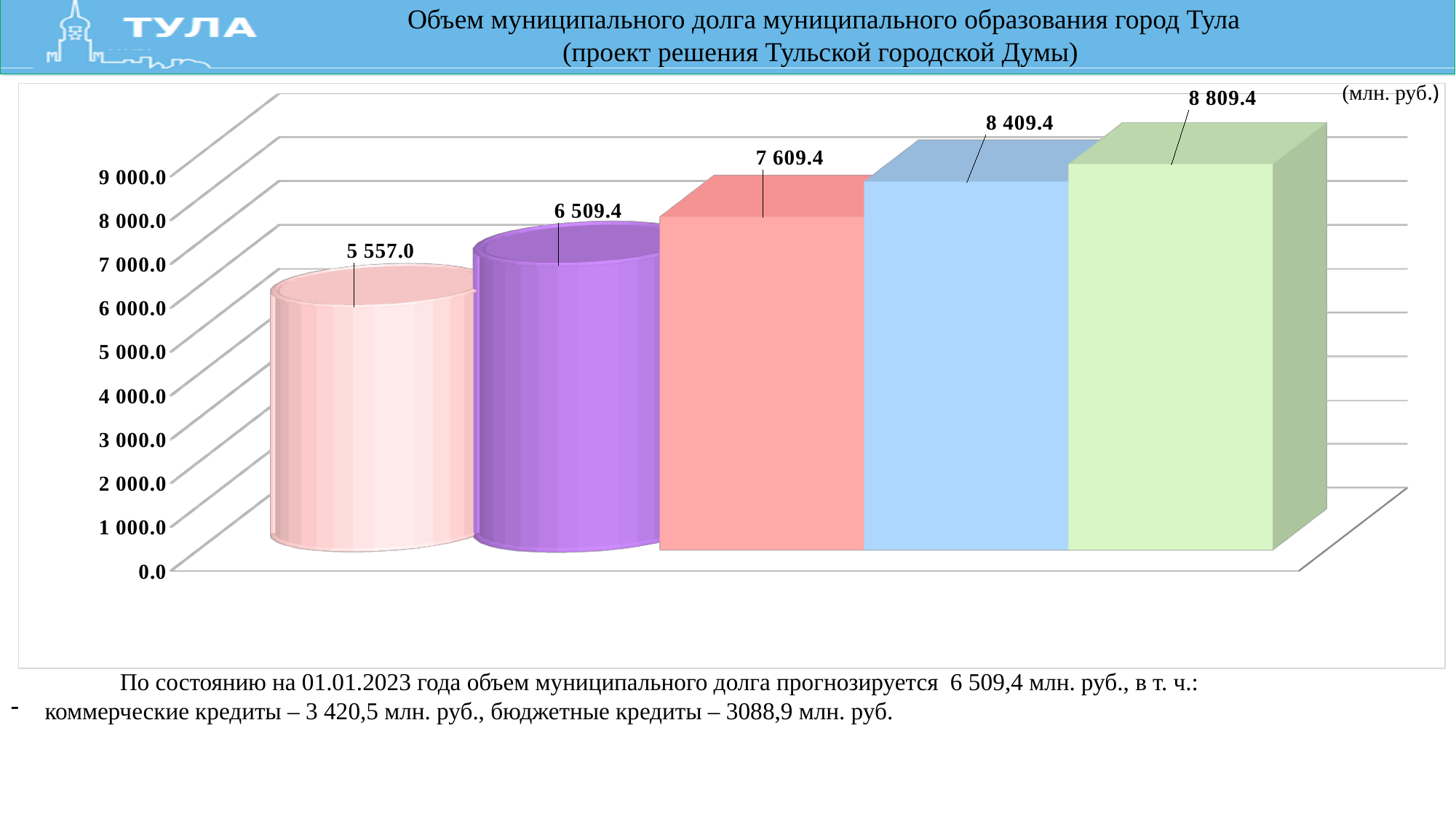
What value is labelled on the leftmost (pink cylinder) bar? 5 557.0 Which bar has the lowest value? The leftmost (pink) bar, 5 557.0 How many bars are plotted in the chart? 5 What is the difference between the rightmost bar (8 809.4) and the leftmost bar (5 557.0)? 3 252.4 Do the values rise or fall from left to right across the chart? Rise What is the difference between the light blue bar and the red bar? 800.0 Which bar has the highest value? The rightmost (green) bar, 8 809.4 What value is labelled on the rightmost (green) bar? 8 809.4 What value is labelled on the light blue bar? 8 409.4 What value is labelled on the middle (red) bar? 7 609.4 What value is labelled on the second bar from the left (purple cylinder)? 6 509.4 What unit is indicated in the top right corner of the chart? млн. руб.